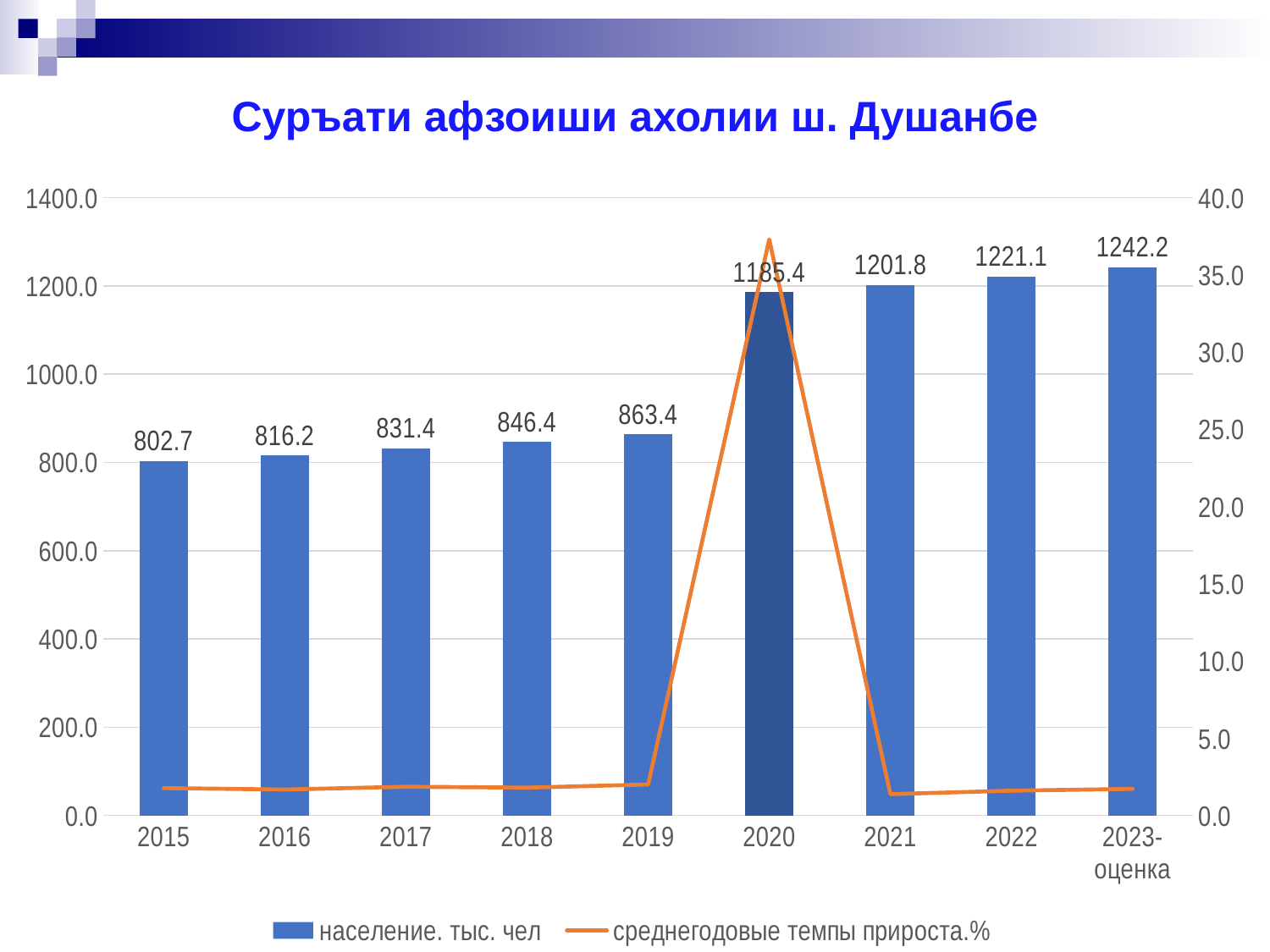
Which year has the lowest population bar? 2015 How many years are shown on the x axis? 9 What is the population value shown for 2020? 1185.4 How many series does the legend list? 2 Is the value of the среднегодовые темпы прироста line for 2015 greater or less than 5.0 on the right axis? less Which is larger, the population value for 2021 or for 2022? 2022 Is the value of the среднегодовые темпы прироста line for 2020 greater or less than 35.0 on the right axis? greater Which year has the highest population bar? 2023-оценка What is the difference between the population values for 2020 and 2019? 322.0 What is the difference between the population values for 2016 and 2015? 13.5 What is the population value shown for 2015? 802.7 What is the population value shown for 2023-оценка? 1242.2